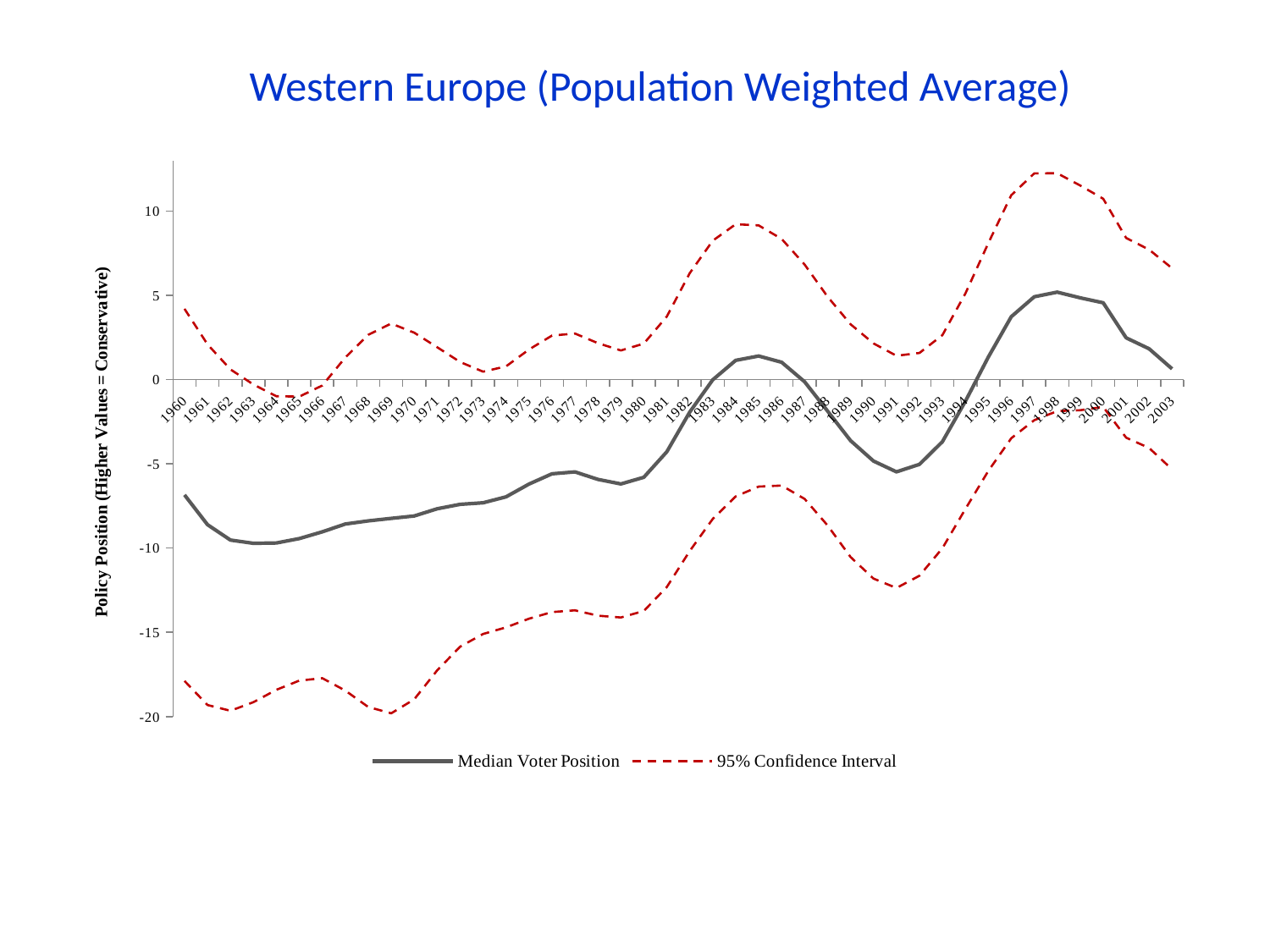
Is the Median Voter Position in 1960 greater or less than -5? less What is the title of the chart? Western Europe (Population Weighted Average) Is the Median Voter Position in 1985 greater or less than 0? greater Which is larger, the Median Voter Position in 1985 or in 1991? 1985 How many years are shown along the x axis? 44 What kind of chart is shown on the slide? line chart Does the Median Voter Position rise or fall between 1991 and 1998? rise Is the Median Voter Position in 1991 greater or less than 0? less What is the label of the vertical axis? Policy Position (Higher Values = Conservative) How many series does the legend list? 2